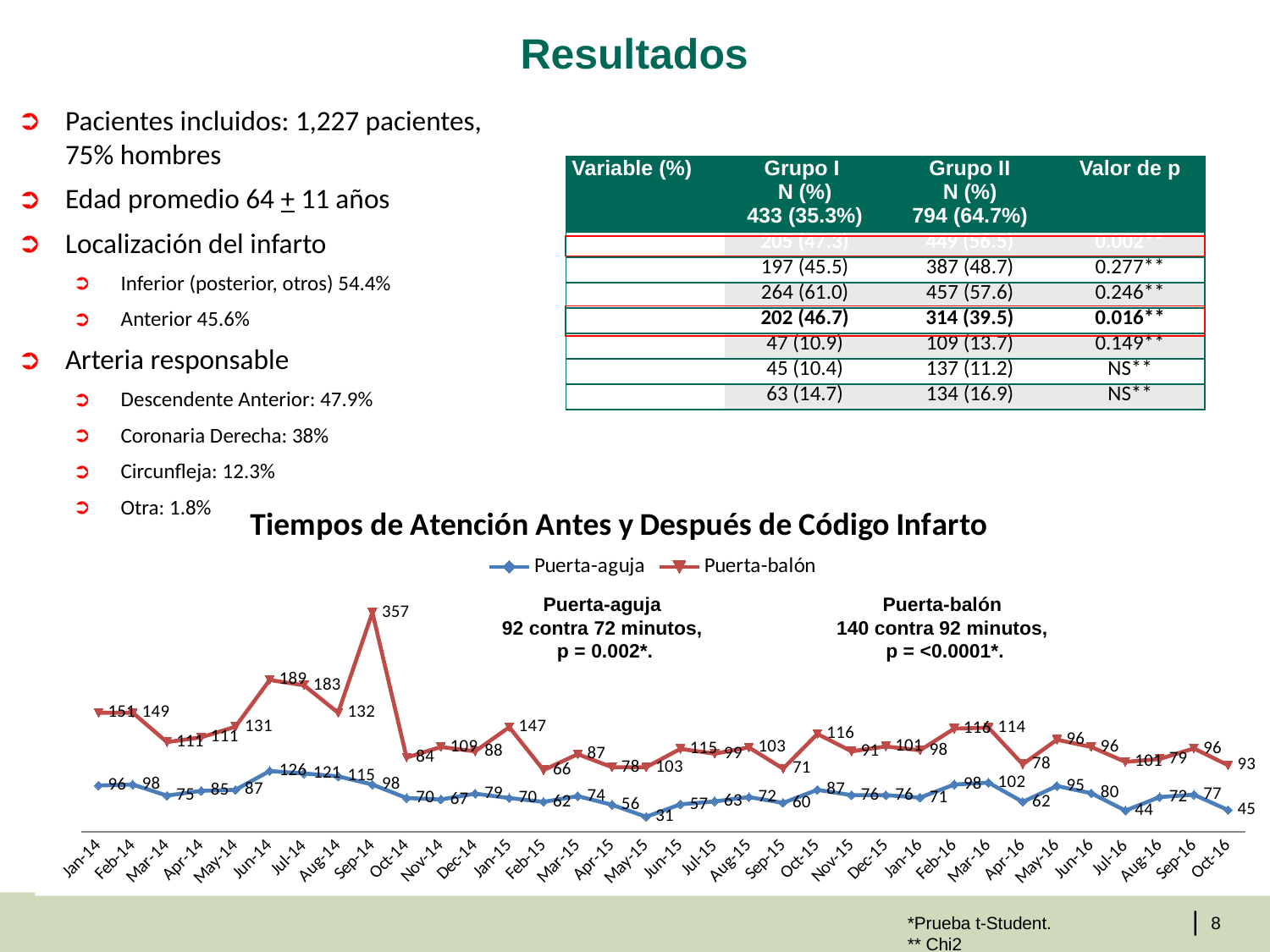
What type of chart is shown on the slide? line chart How many months are plotted along the x axis of the chart? 34 Does the Puerta-aguja series overall rise or fall from Jan-14 to Oct-16? fall What is the Puerta-balón value for Jun-14? 189 What is the Puerta-balón value for Sep-14? 357 In which month does the Puerta-aguja series reach its lowest value? May-15 What is the difference between the Puerta-balón and Puerta-aguja values in Sep-14? 259 What is the title of the chart? Tiempos de Atención Antes y Después de Código Infarto How many series does the legend of the chart list? 2 In Jan-14, which series has the larger value, Puerta-aguja or Puerta-balón? Puerta-balón What is the Puerta-aguja value for Oct-16? 45 In which month does the Puerta-balón series reach its highest value? Sep-14